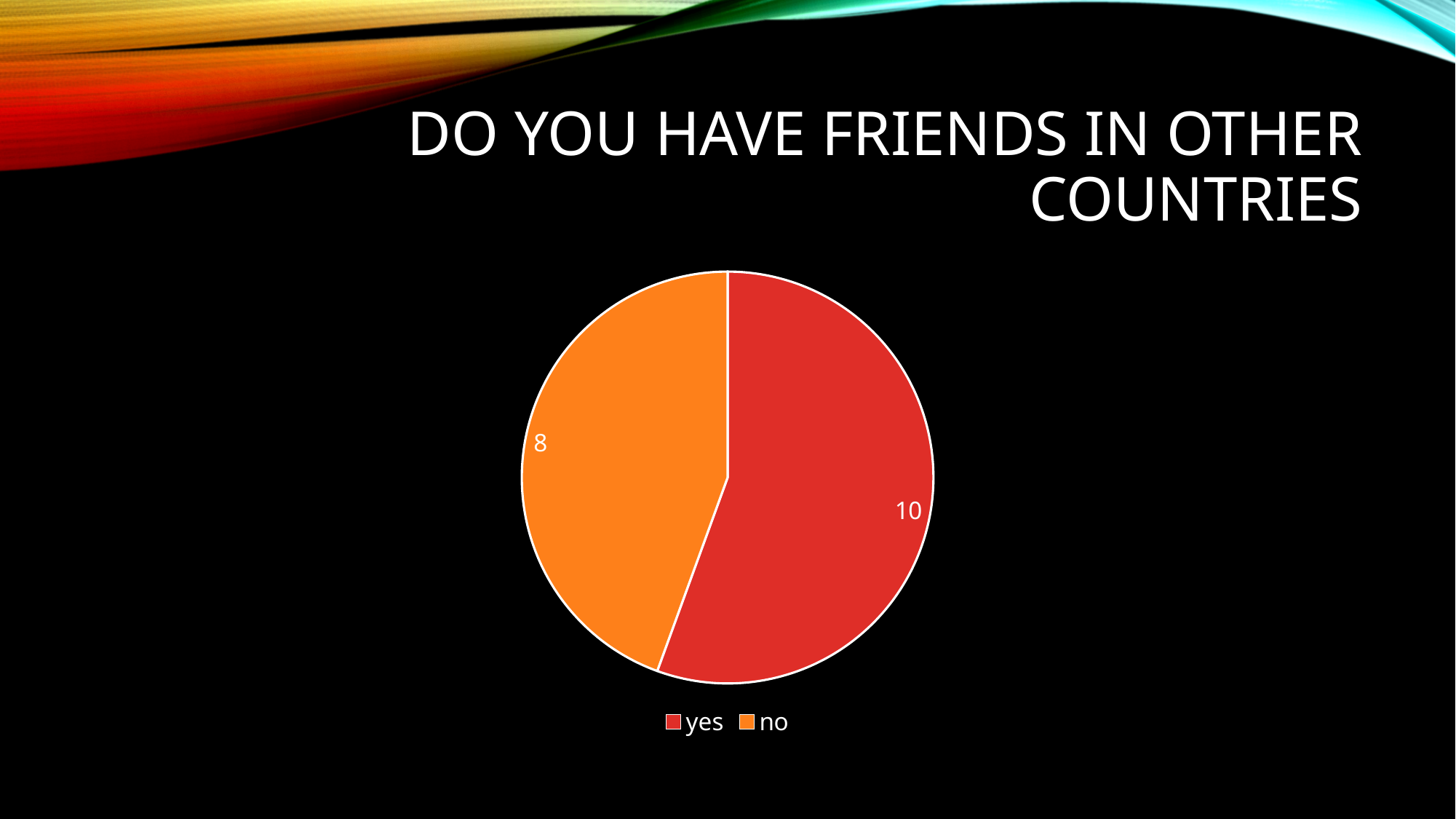
What colour is the "no" slice? orange How many categories does the pie chart have? 2 What is the difference between the values for "yes" and "no"? 2 Which category has the smallest slice? no What is the total of all slices in the pie chart? 18 Which category has the largest slice? yes What is the value for "no"? 8 What kind of chart is shown on the slide? pie chart What is the value for "yes"? 10 What is the title of the slide? DO YOU HAVE FRIENDS IN OTHER COUNTRIES Which is larger, the value for "yes" or the value for "no"? yes